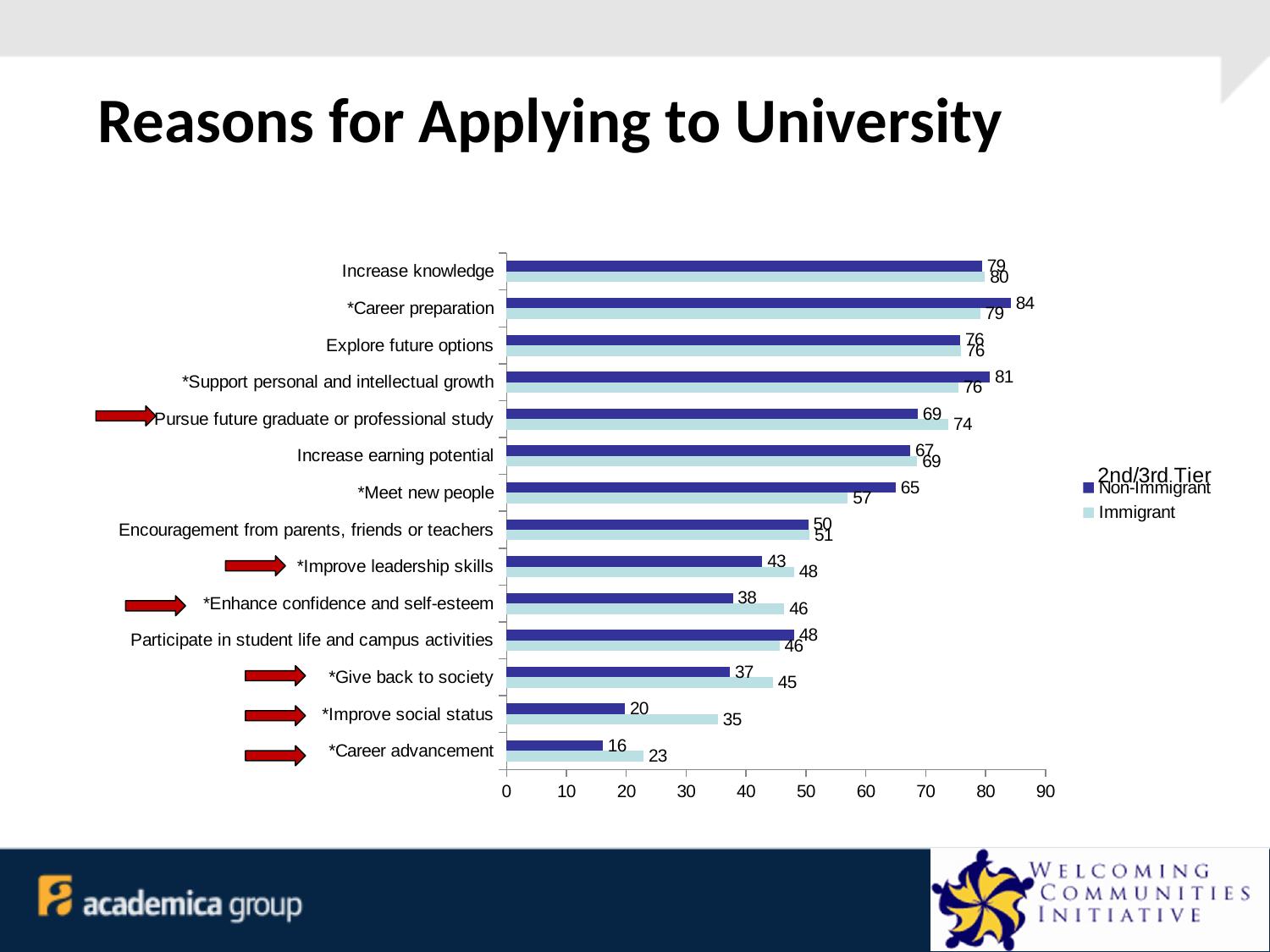
How many categories are shown on the chart? 14 What kind of chart is shown on the slide? Bar chart What is the difference between the Immigrant and Non-Immigrant values for *Improve social status? 15 What is the Immigrant value for *Improve social status? 35 What is the Non-Immigrant value for *Give back to society? 37 What is the Immigrant value for Pursue future graduate or professional study? 74 For *Meet new people, which series has the larger value, Non-Immigrant or Immigrant? Non-Immigrant What is the title of the slide? Reasons for Applying to University Which category has the lowest Immigrant value? *Career advancement How many series does the legend list? 2 What is the Non-Immigrant value for *Career preparation? 84 Which category has the highest Non-Immigrant value? *Career preparation